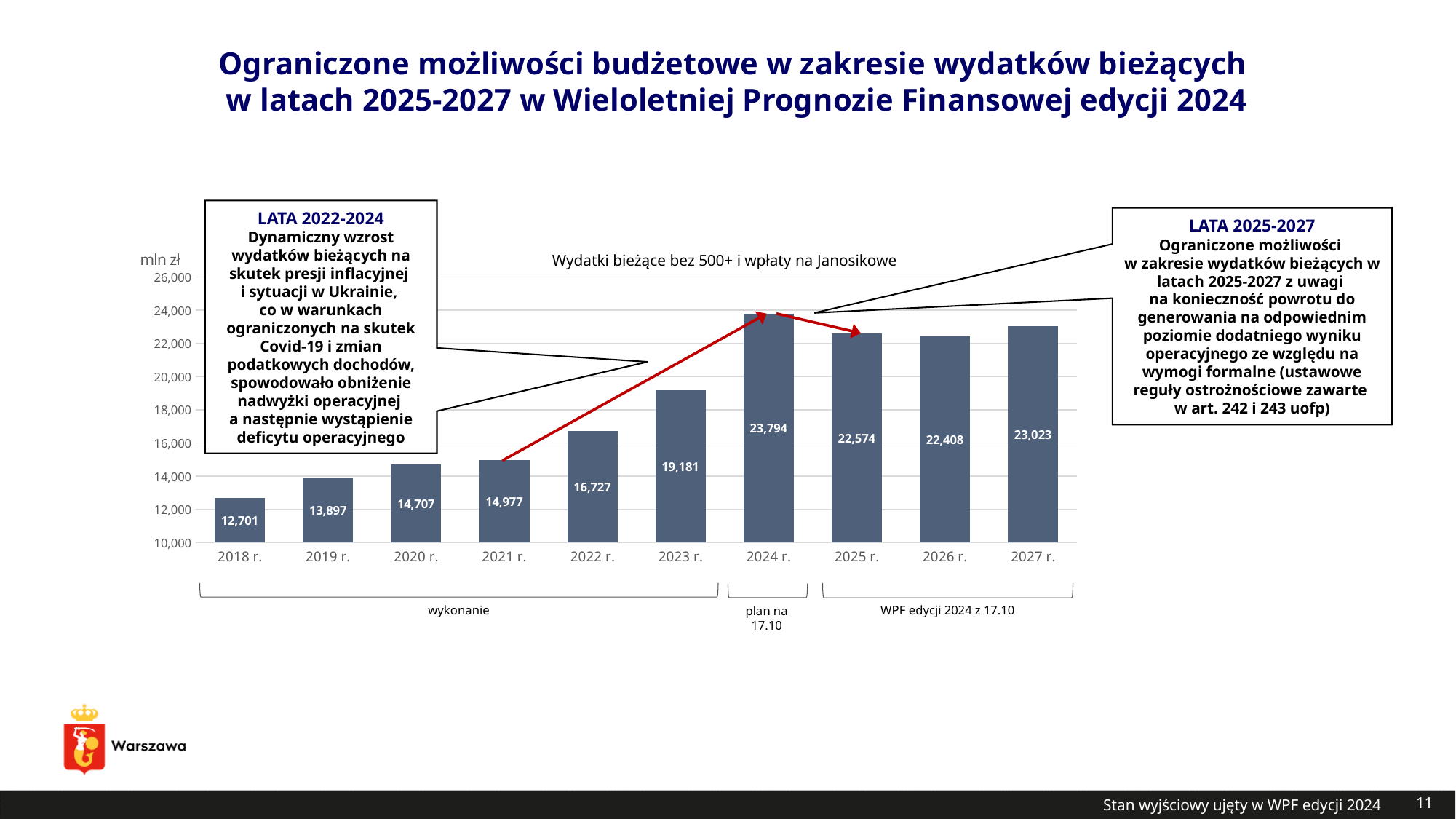
Do the values rise or fall from 2018 r. to 2024 r.? rise What is the value for 2024 r.? 23,794 What is the value for 2018 r.? 12,701 How many years are shown on the x axis? 10 Which is larger, the value for 2026 r. or the value for 2027 r.? 2027 r. Which year has the highest value? 2024 r. What is the value for 2027 r.? 23,023 What is the title of the chart? Wydatki bieżące bez 500+ i wpłaty na Janosikowe Which year has the lowest value? 2018 r. What is the difference between the values for 2024 r. and 2025 r.? 1,220 Is the value for 2023 r. greater or less than 18,000? greater What kind of chart is shown? bar chart